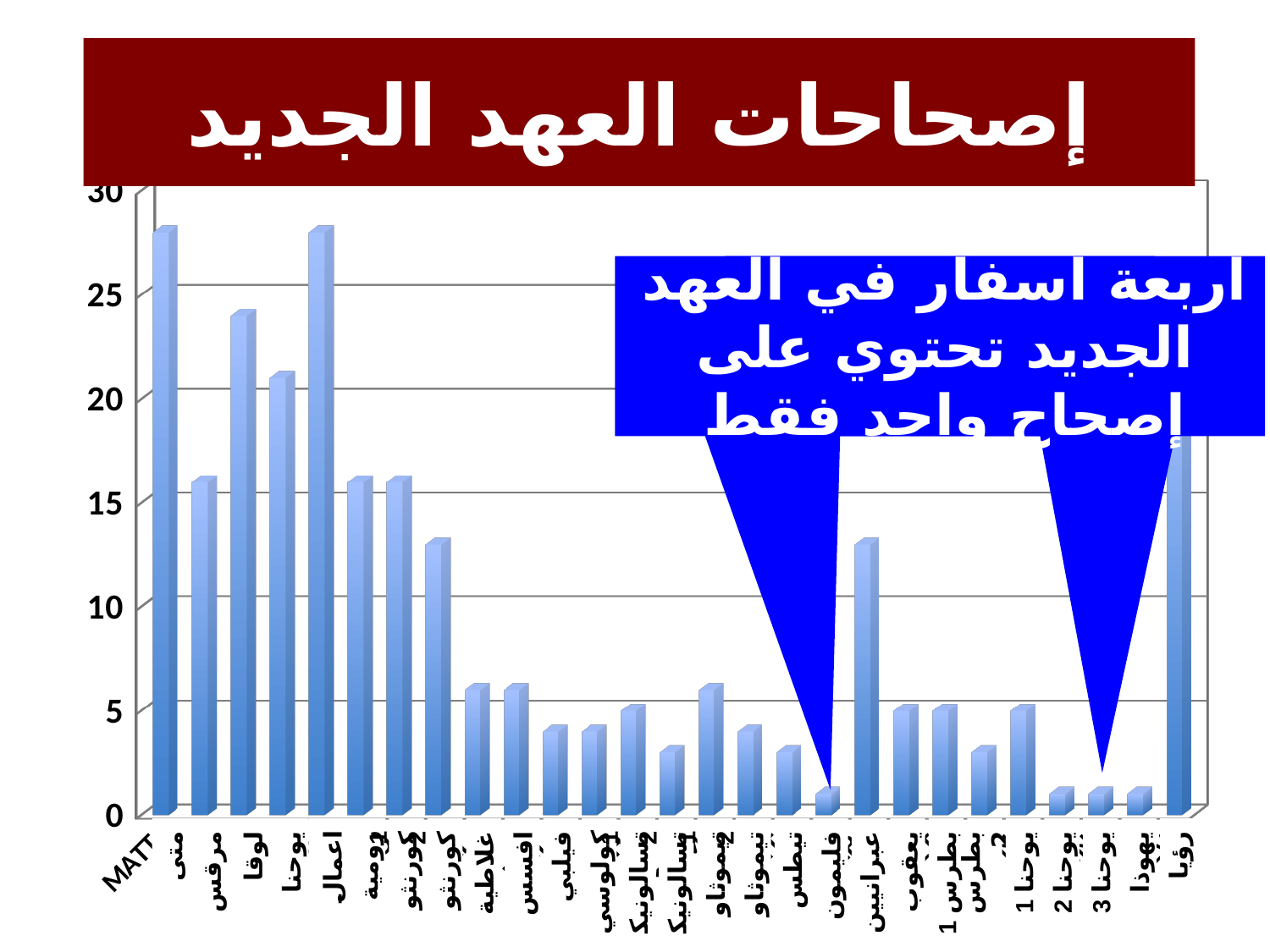
Which has the larger value, لوقا or مرقس? لوقا Is the value for عبرانيين greater or less than 10? greater Is the value for رؤيا greater or less than 20? greater Is the value for اعمال greater or less than 25? greater According to the blue callout on the chart, how many books of the New Testament contain only one chapter? اربعة (four) Which has the larger value, عبرانيين or يعقوب? عبرانيين How many categories (bars) are plotted along the x axis? 27 What is the title of the chart on the slide? إصحاحات العهد الجديد What kind of chart is shown on the slide? bar chart